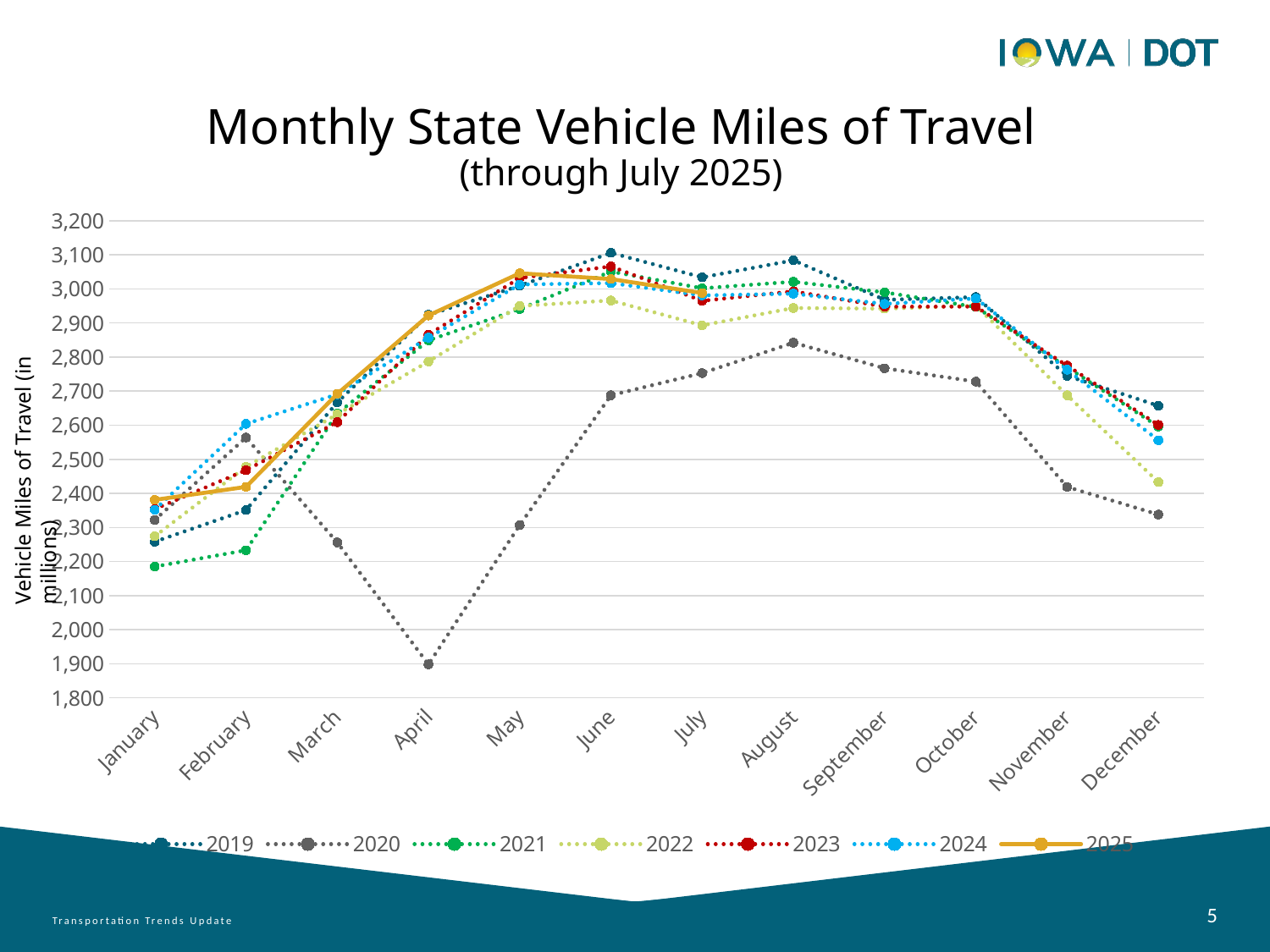
Which is larger in April, the value for 2019 or the value for 2020? 2019 What is the label on the vertical axis of the chart? Vehicle Miles of Travel (in millions) What kind of chart is shown on the slide? line chart Is the value for 2020 in December greater or less than 2,400? less How many series does the legend list? 7 Is the value for 2019 in June greater or less than 3,000? greater How many months are shown along the x axis? 12 Is the value for 2025 in May greater or less than 3,000? greater Which month has the lowest value for the 2020 series? April Does the 2020 series rise or fall from April to August? rise Which series has the lowest value in December? 2020